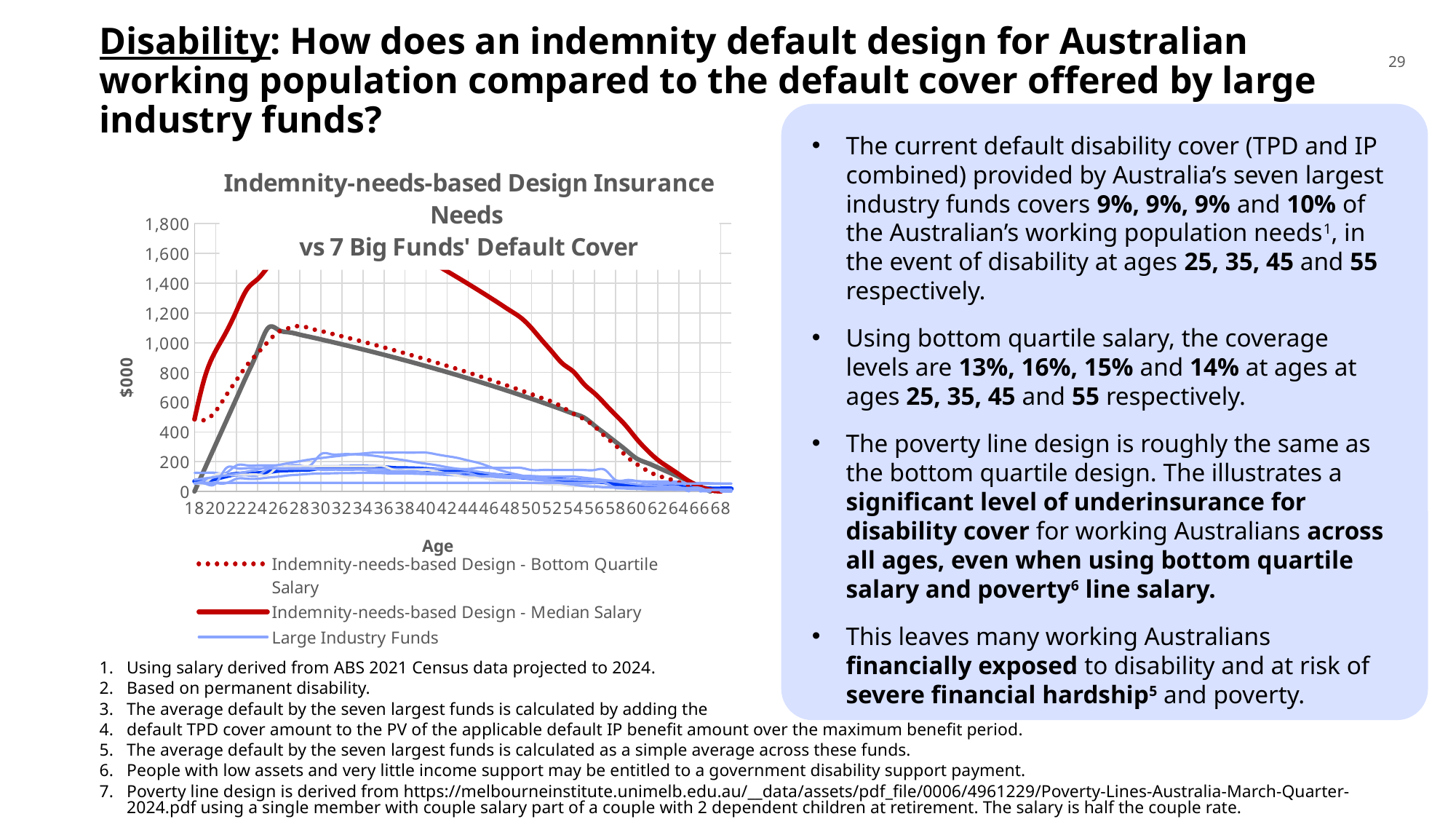
Is the value for Indemnity-needs-based Design - Bottom Quartile Salary at age 26 greater or less than 800? greater Are the Large Industry Funds values at age 40 greater or less than 400? less Which series reaches the highest values on the chart? Indemnity-needs-based Design - Median Salary Does the Indemnity-needs-based Design - Median Salary line rise or fall between age 50 and age 68? fall Is the value for Indemnity-needs-based Design - Median Salary at age 50 greater or less than 800? greater What kind of chart is shown on the slide? line chart At age 40, which is larger: Indemnity-needs-based Design - Median Salary or Large Industry Funds? Indemnity-needs-based Design - Median Salary How many series does the chart legend list? 3 At age 20, which is larger: Indemnity-needs-based Design - Median Salary or Indemnity-needs-based Design - Bottom Quartile Salary? Indemnity-needs-based Design - Median Salary What is the label on the horizontal axis of the chart? Age What is the label on the vertical axis of the chart? $000